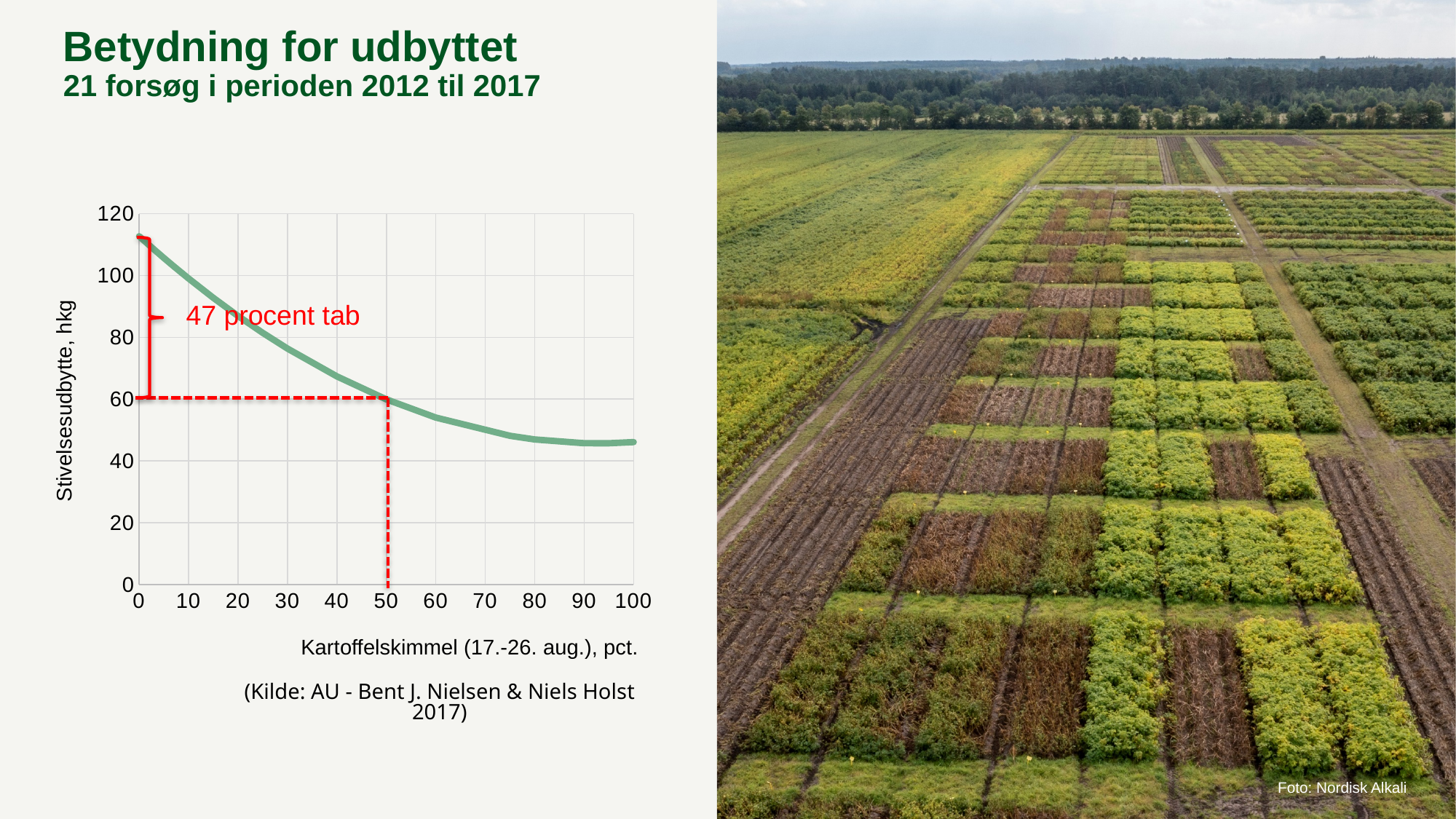
Is the starch yield at 20 pct. Kartoffelskimmel greater or less than 80 hkg? greater What is the highest value shown on the y axis of the chart? 120 Is the starch yield at 80 pct. Kartoffelskimmel greater or less than 40 hkg? greater What kind of chart is shown on the slide? line chart What percentage loss does the red annotation on the chart state? 47 procent tab Is the starch yield at 0 pct. Kartoffelskimmel greater or less than 100 hkg? greater What is the label of the y axis of the chart? Stivelsesudbytte, hkg Does the starch yield (Stivelsesudbytte) rise or fall as Kartoffelskimmel increases along the x axis? fall How many lines (series) are plotted on the chart? 1 What starch yield in hkg does the dashed red line mark at 50 pct. Kartoffelskimmel? 60 Which is larger, the starch yield at 10 pct. Kartoffelskimmel or at 70 pct.? 10 pct.